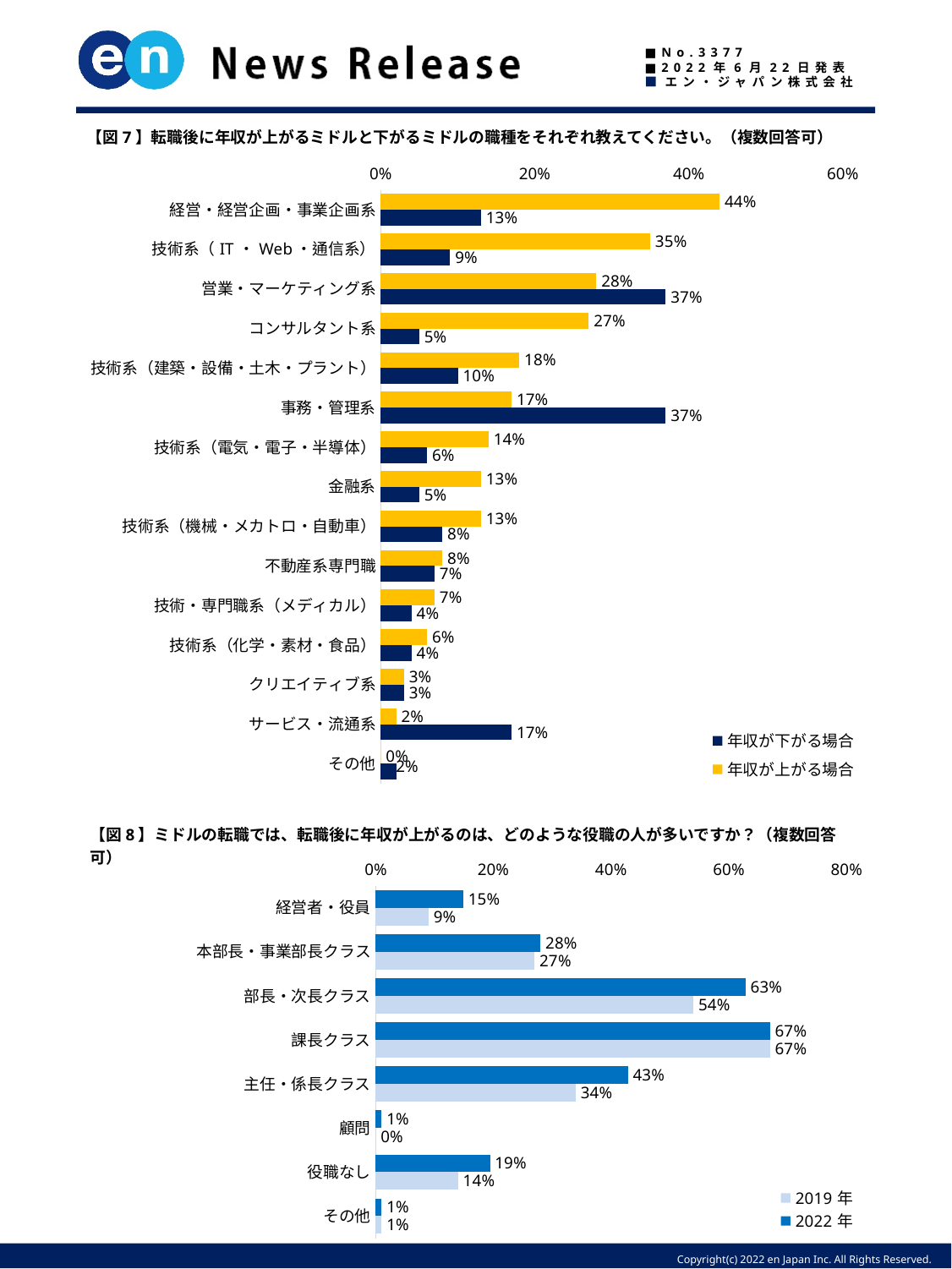
In the 図8 chart, what is the value for 部長・次長クラス in 2022年? 63% In the 図8 chart, what is the difference between the 2022年 and 2019年 values for 主任・係長クラス? 9% In the 図8 chart, which colour represents the 2019年 series? Light blue In the 図7 chart, what is the difference between the 年収が上がる場合 and 年収が下がる場合 values for コンサルタント系? 22% In the 図7 chart, which category has the highest value in the 年収が上がる場合 series? 経営・経営企画・事業企画系 How many categories are shown in the 図7 chart? 15 In the 図7 chart, what is the value for 事務・管理系 in the 年収が下がる場合 series? 37% What kind of chart is the 図8 chart? Bar chart In the 図7 chart, what is the value for 経営・経営企画・事業企画系 in the 年収が上がる場合 series? 44% In the 図8 chart, which category has the highest value in the 2022年 series? 課長クラス How many series does the legend of the 図7 chart list? 2 In the 図7 chart, for サービス・流通系, which series has the larger value: 年収が上がる場合 or 年収が下がる場合? 年収が下がる場合